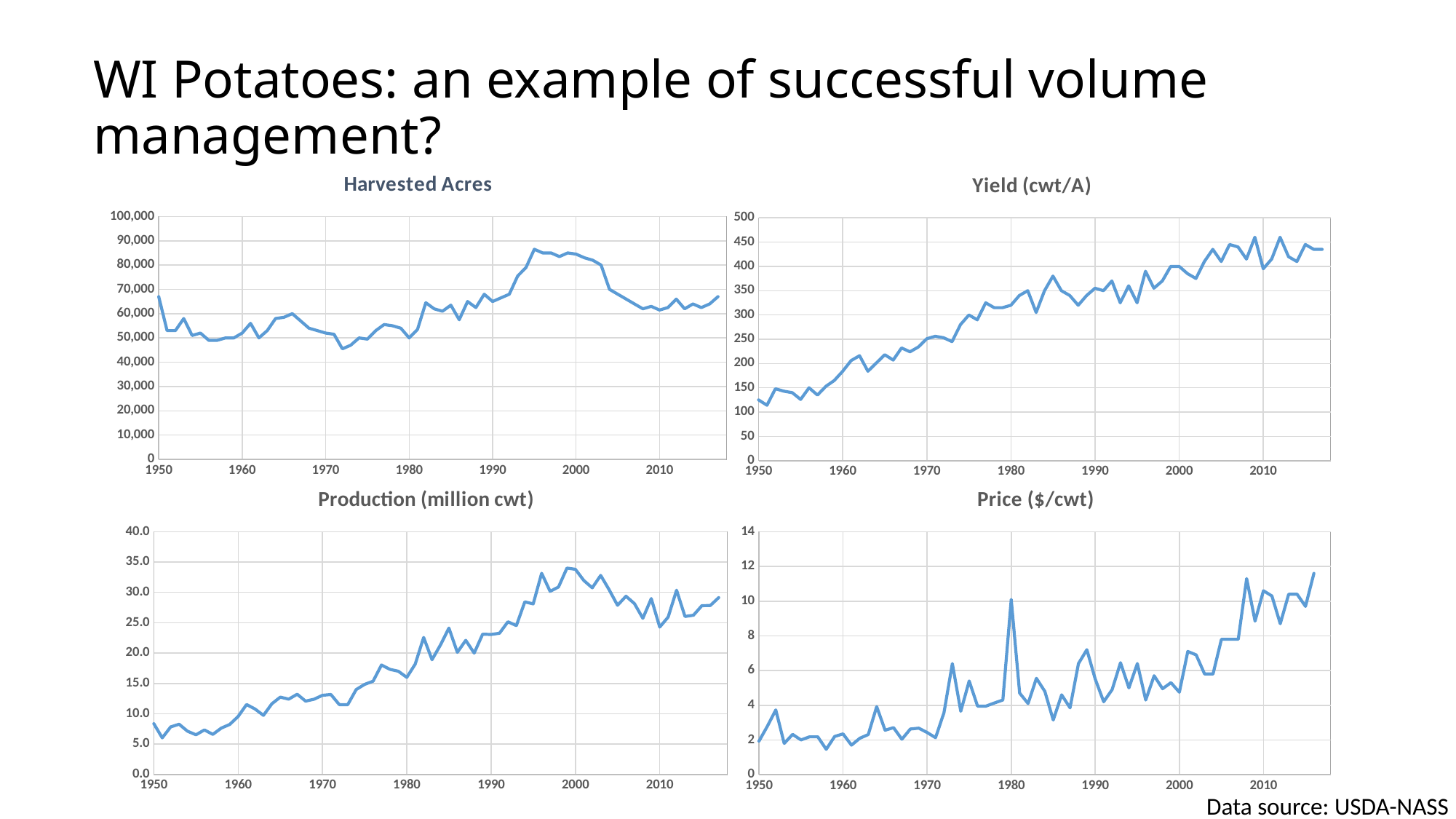
What is the title of the top-right chart? Yield (cwt/A) What kind of chart is the Harvested Acres chart? line chart In the Yield (cwt/A) chart, is the value for 1950 greater or less than 150? less How many charts are shown on the slide? 4 In the Harvested Acres chart, is the value for 1995 greater or less than 80,000? greater In the Production (million cwt) chart, do values generally rise or fall between 1950 and 2000? rise In the Production (million cwt) chart, is the value for 1950 greater or less than 10.0? less What data source is cited on the slide? USDA-NASS In the Yield (cwt/A) chart, do values generally rise or fall from 1950 to the end of the series? rise